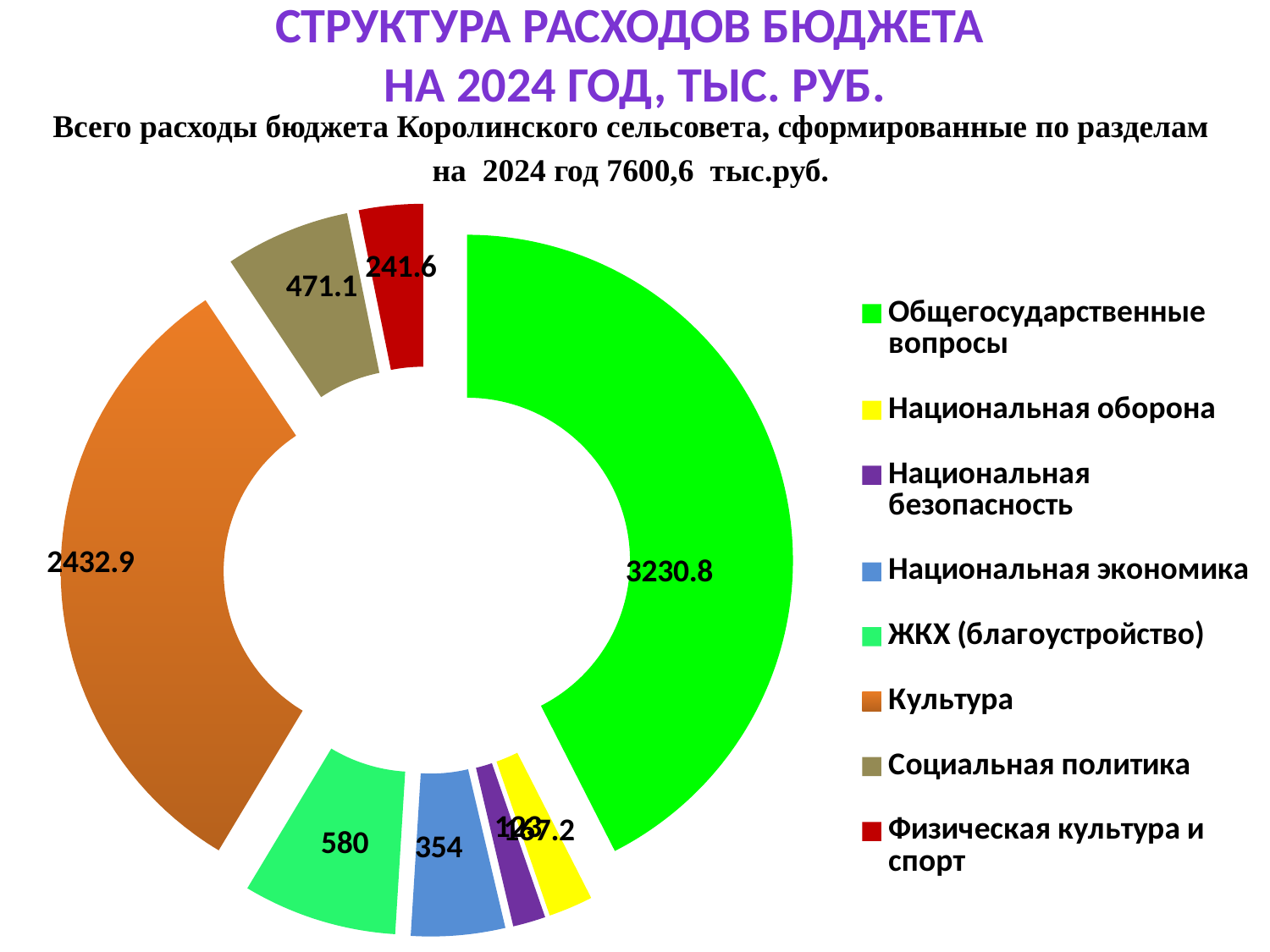
Which is larger, Социальная политика or Физическая культура и спорт? Социальная политика What is the difference between Общегосударственные вопросы and Культура? 797.9 What is the difference between ЖКХ (благоустройство) and Национальная экономика? 226 What kind of chart is shown on the slide? Doughnut (pie) chart What is the value for Социальная политика? 471.1 What is the value for Культура? 2432.9 What is the value for Физическая культура и спорт? 241.6 What is the value for ЖКХ (благоустройство)? 580 What is the value for Национальная экономика? 354 Which category has the largest value? Общегосударственные вопросы How many categories does the legend list? 8 What is the value for Общегосударственные вопросы? 3230.8